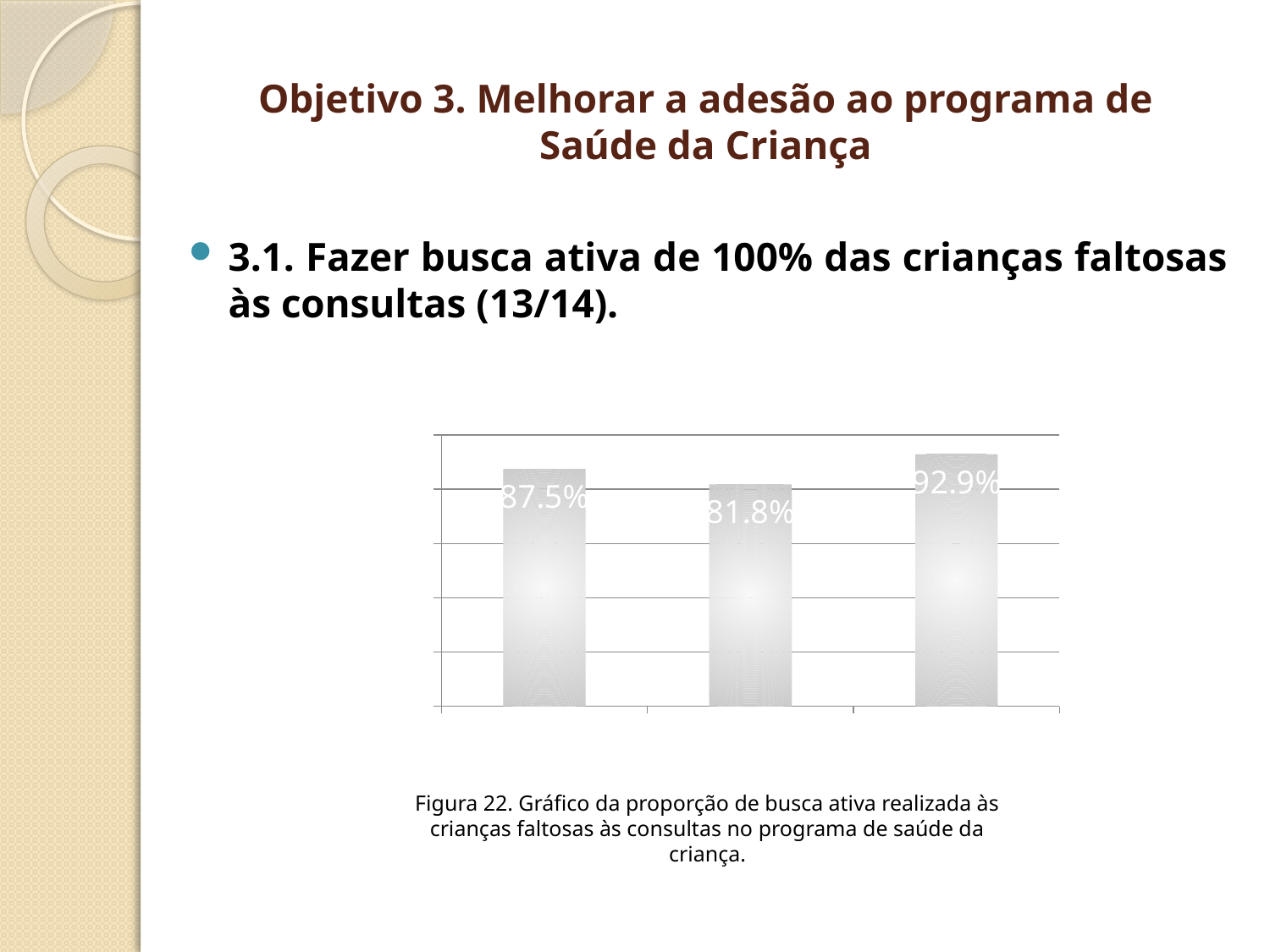
What is the difference between the value of the third bar and the value of the second bar? 11.1% Which bar has the highest value: the first, second or third? the third What kind of chart is shown on the slide? bar chart What is the value shown on the third (rightmost) bar of the chart? 92.9% What figure number is given in the caption below the chart? Figura 22 Which bar has the lowest value: the first, second or third? the second How many bars are plotted in the chart? 3 What is the value shown on the middle bar of the chart? 81.8% What is the difference between the value of the first bar and the value of the second bar? 5.7% Does the value rise or fall from the second bar to the third bar? rise Which is larger, the value of the first bar or the value of the third bar? the third bar What is the value shown on the first (leftmost) bar of the chart? 87.5%